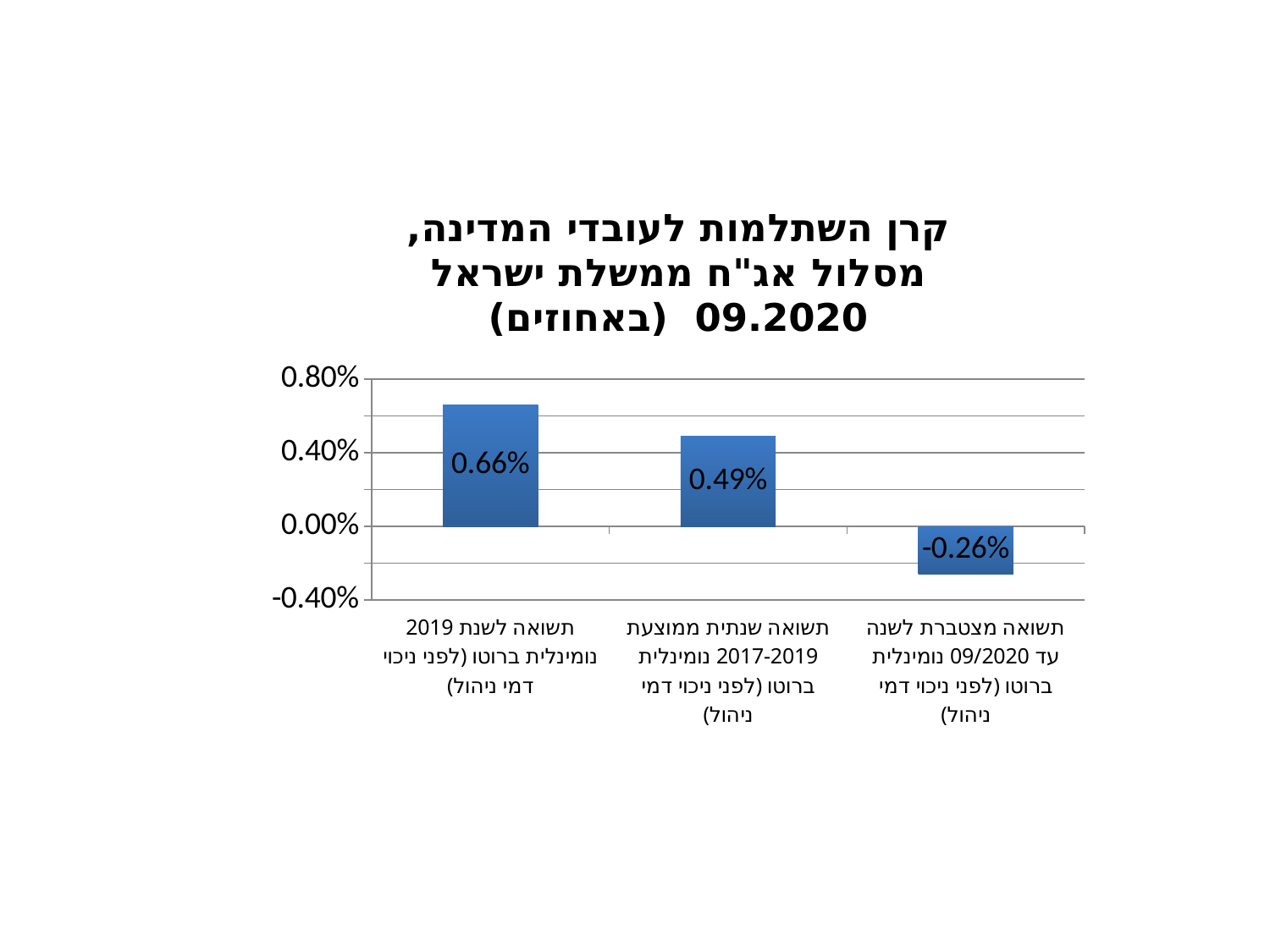
What type of chart is shown on the slide? Bar chart Is the value for the average annual return 2017-2019 greater or less than 0.40%? greater What is the value for the average annual return 2017-2019 (תשואה שנתית ממוצעת 2017-2019)? 0.49% What is the value for the 2019 return (תשואה לשנת 2019 נומינלית ברוטו)? 0.66% How many bars are shown in the chart? 3 What is the difference between the 2019 return (0.66%) and the average annual return 2017-2019 (0.49%)? 0.17% Which is larger: the 2019 return or the average annual return 2017-2019? The 2019 return (0.66%) How many bars have a negative value? 1 What is the lowest value shown on the vertical axis? -0.40% What is the value for the cumulative return for the year to 09/2020 (תשואה מצטברת לשנה עד 09/2020)? -0.26% Which category has the lowest value? תשואה מצטברת לשנה עד 09/2020 נומינלית ברוטו (לפני ניכוי דמי ניהול) Which category has the highest value? תשואה לשנת 2019 נומינלית ברוטו (לפני ניכוי דמי ניהול)